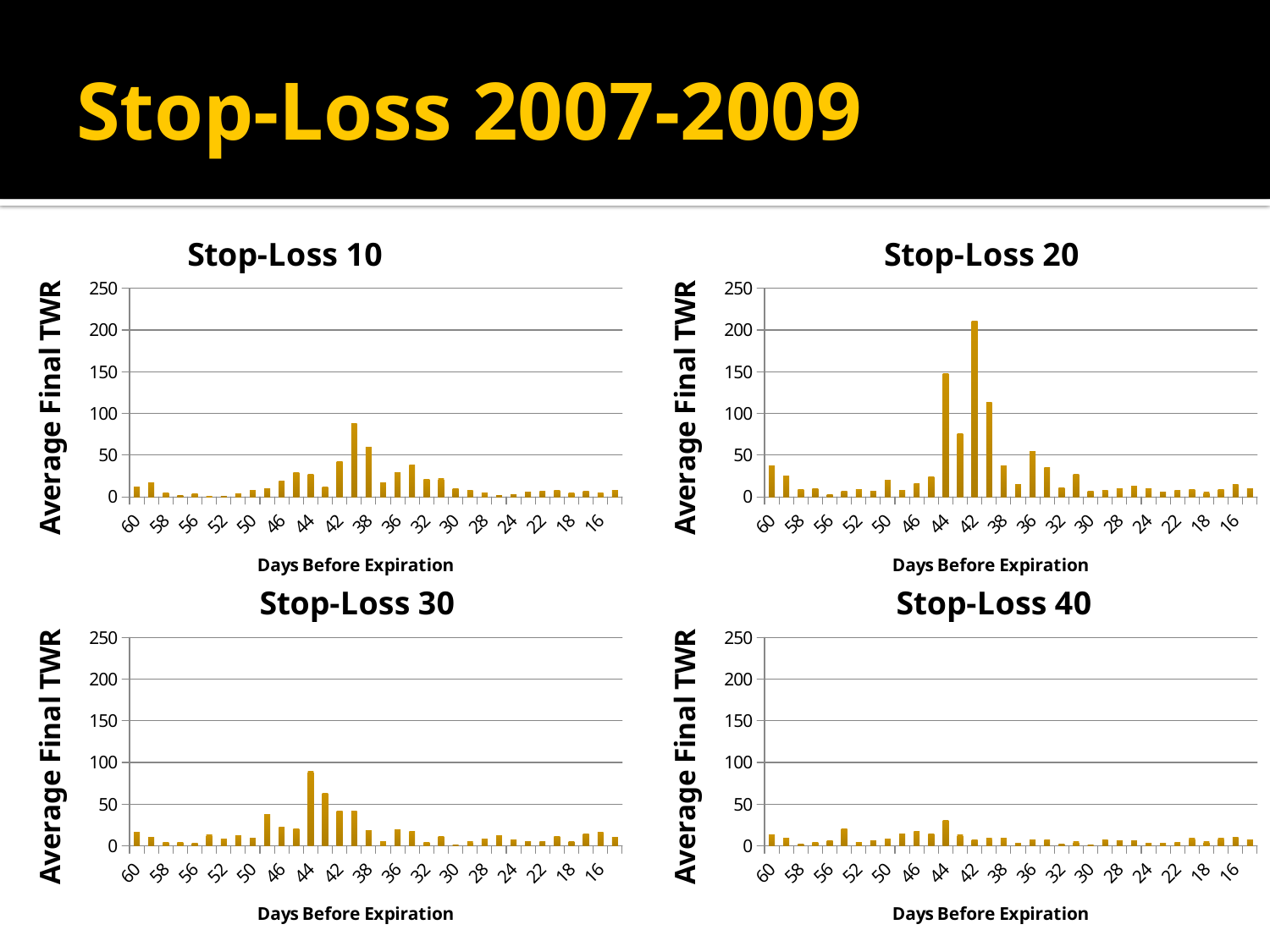
Which of the four charts on the slide contains the tallest bar? Stop-Loss 20 In the Stop-Loss 20 chart, which days-before-expiration value has the highest bar? 42 In the Stop-Loss 40 chart, which days-before-expiration value has the highest bar? 44 In the Stop-Loss 30 chart, which days-before-expiration value has the highest bar? 44 What kind of chart is the Stop-Loss 10 chart? bar chart In the Stop-Loss 20 chart, is the value at 44 days before expiration greater or less than 100? greater In the Stop-Loss 20 chart, is the value at 42 days before expiration greater or less than 200? greater What is the y-axis label on the Stop-Loss 10 chart? Average Final TWR In the Stop-Loss 40 chart, is the value at 44 days before expiration greater or less than 50? less Which is larger: the value at 42 days before expiration in the Stop-Loss 20 chart or in the Stop-Loss 10 chart? Stop-Loss 20